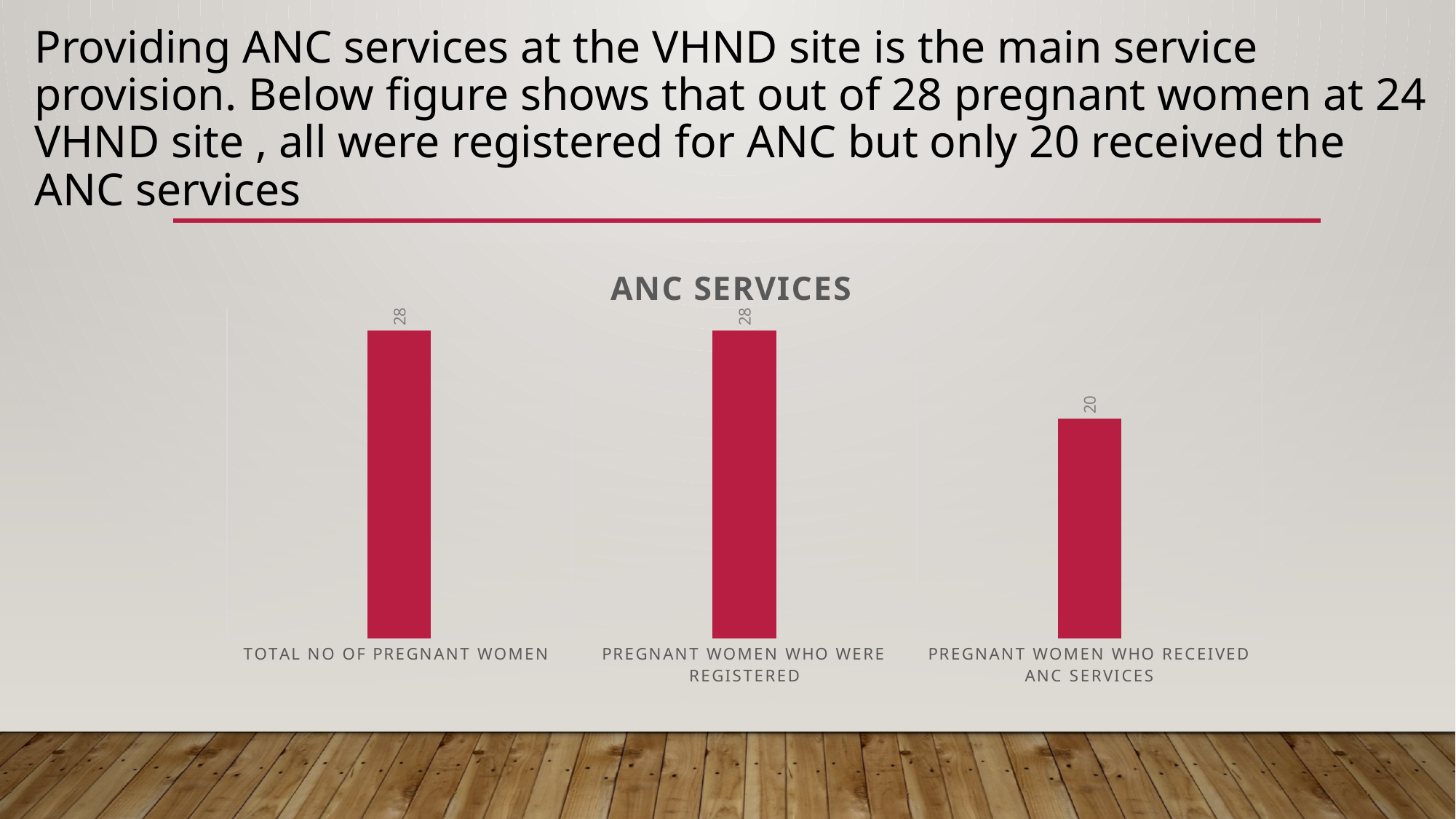
What is the value for Total no of pregnant women? 28 What colour are the bars in the chart? Red How many categories are shown in the chart? 3 Which category has the lowest value? Pregnant women who received ANC services What is the value for Pregnant women who were registered? 28 What is the difference between Pregnant women who were registered and Pregnant women who received ANC services? 8 What kind of chart is shown on the slide? Bar chart What is the value for Pregnant women who received ANC services? 20 Do the values rise or fall from the first category to the last? Fall What is the title of the chart? ANC SERVICES Which is larger: Total no of pregnant women or Pregnant women who received ANC services? Total no of pregnant women